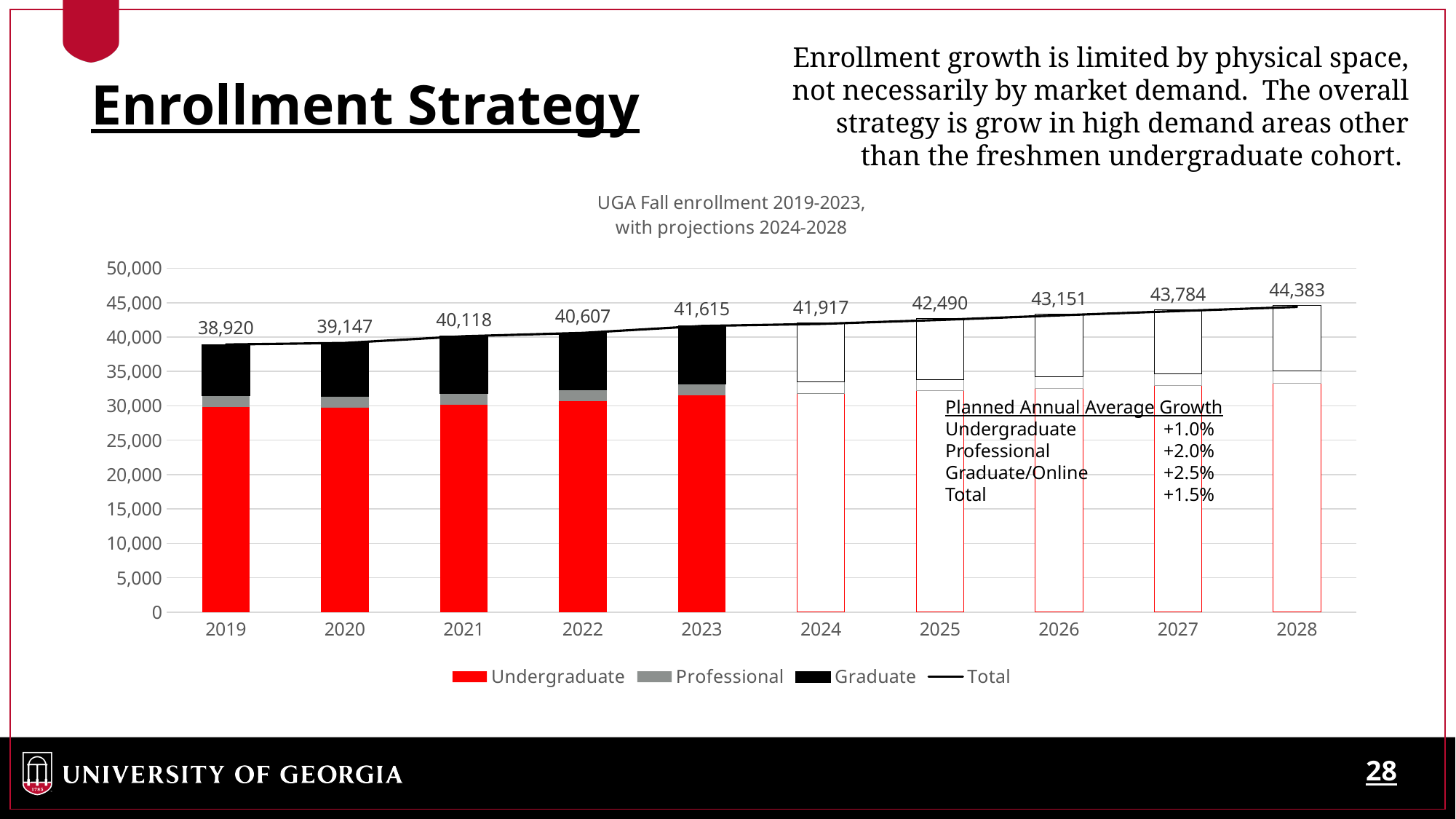
Which year has the lowest total enrollment value on the chart? 2019 What kind of chart is used to show the enrollment data? Stacked bar chart with a line for Total Which year has the highest total enrollment value on the chart? 2028 What is the difference between the total enrollment values for 2023 and 2019? 2,695 Which year has a larger total enrollment value, 2021 or 2025? 2025 What is the total enrollment value shown for 2023? 41,615 What is the total enrollment value shown for 2019? 38,920 How many years are shown on the x axis of the chart? 10 What is the projected total enrollment shown for 2028? 44,383 How many series does the chart legend list? 4 Does the total enrollment rise or fall from 2019 to 2028? Rise Is the Undergraduate value for 2023 greater or less than 30,000? greater